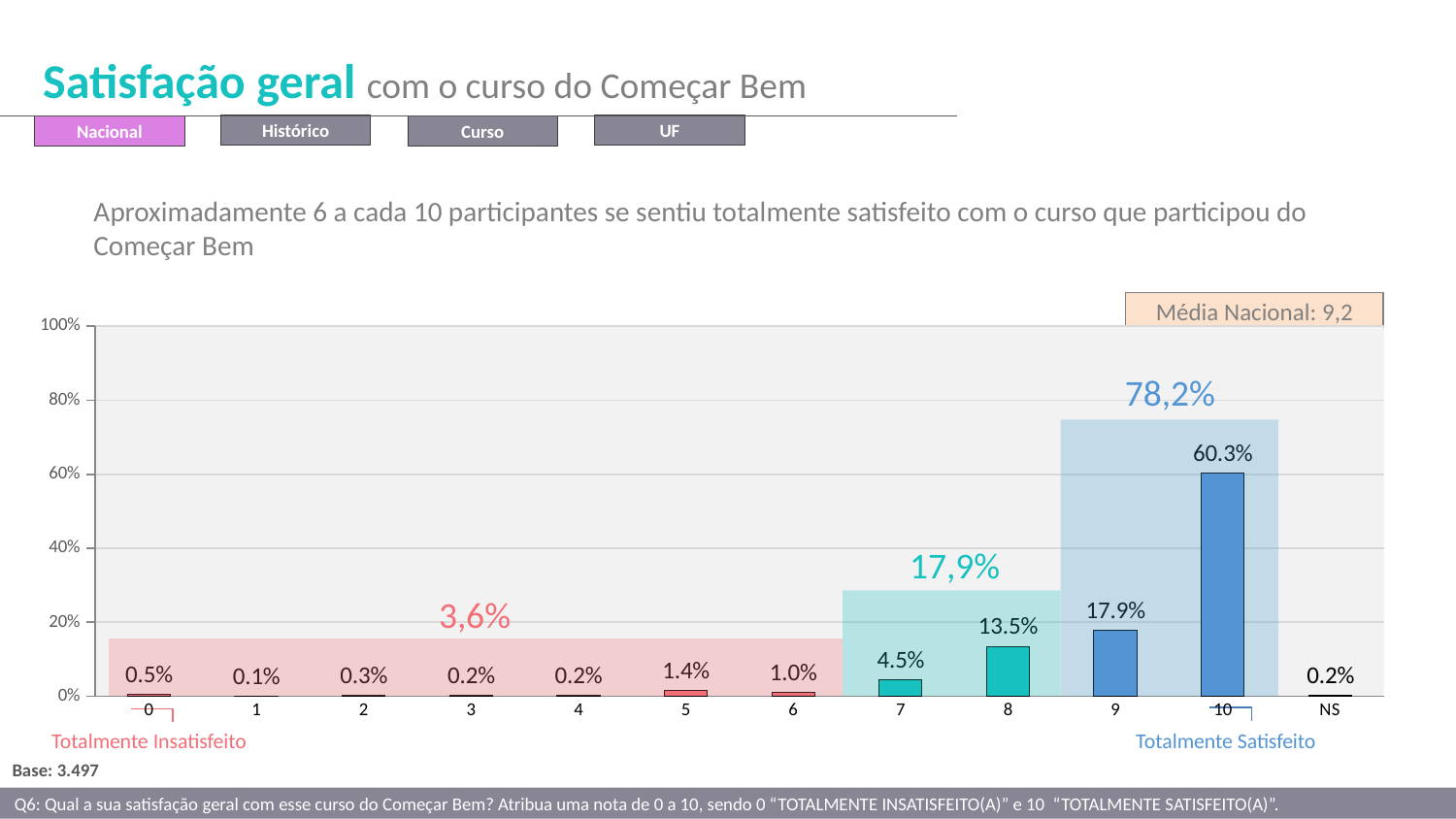
Which is larger, the value for score 5 or the value for score 6? 5 What is the combined percentage shown for the group of scores 9 and 10? 78,2% How many categories are shown on the x axis? 12 Is the value for score 10 greater or less than 60%? greater What is the value for score 8? 13.5% What is the difference between the values for score 10 and score 9? 42.4% What is the value for score 10? 60.3% What kind of chart is shown on the slide? bar chart Which category has the lowest value? 1 Which category has the highest value? 10 What is the value for the NS category? 0.2% What is the value for score 7? 4.5%